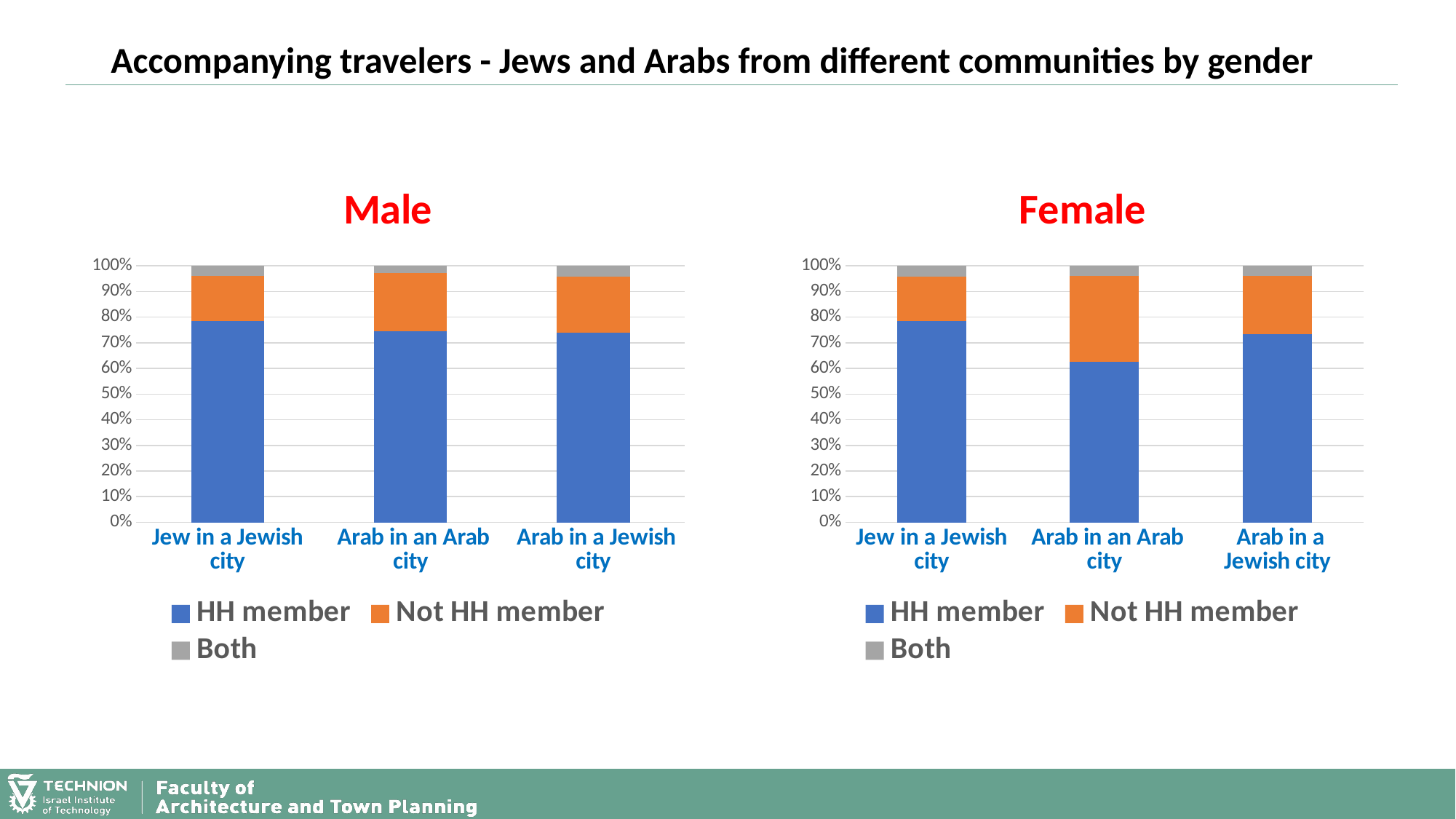
For Arab in an Arab city, is the HH member share larger in the Male chart or the Female chart? Male In the Male chart, which category has the highest HH member share? Jew in a Jewish city What kind of chart is the Male chart? Stacked bar chart How many series does the legend of the Male chart list? 3 How many categories are shown on the x axis of the Female chart? 3 Which colour represents the 'Both' series in the legend of the Male chart? Grey In the Female chart, which category has the lowest HH member share? Arab in an Arab city In the Female chart, is the HH member share for Arab in an Arab city greater or less than 70%? less In the Female chart, which category has the highest HH member share? Jew in a Jewish city In the Female chart, which is larger: the HH member share for Jew in a Jewish city or for Arab in an Arab city? Jew in a Jewish city In the Male chart, is the HH member share for Jew in a Jewish city greater or less than 70%? greater In the Female chart, is the HH member share for Arab in a Jewish city greater or less than 60%? greater